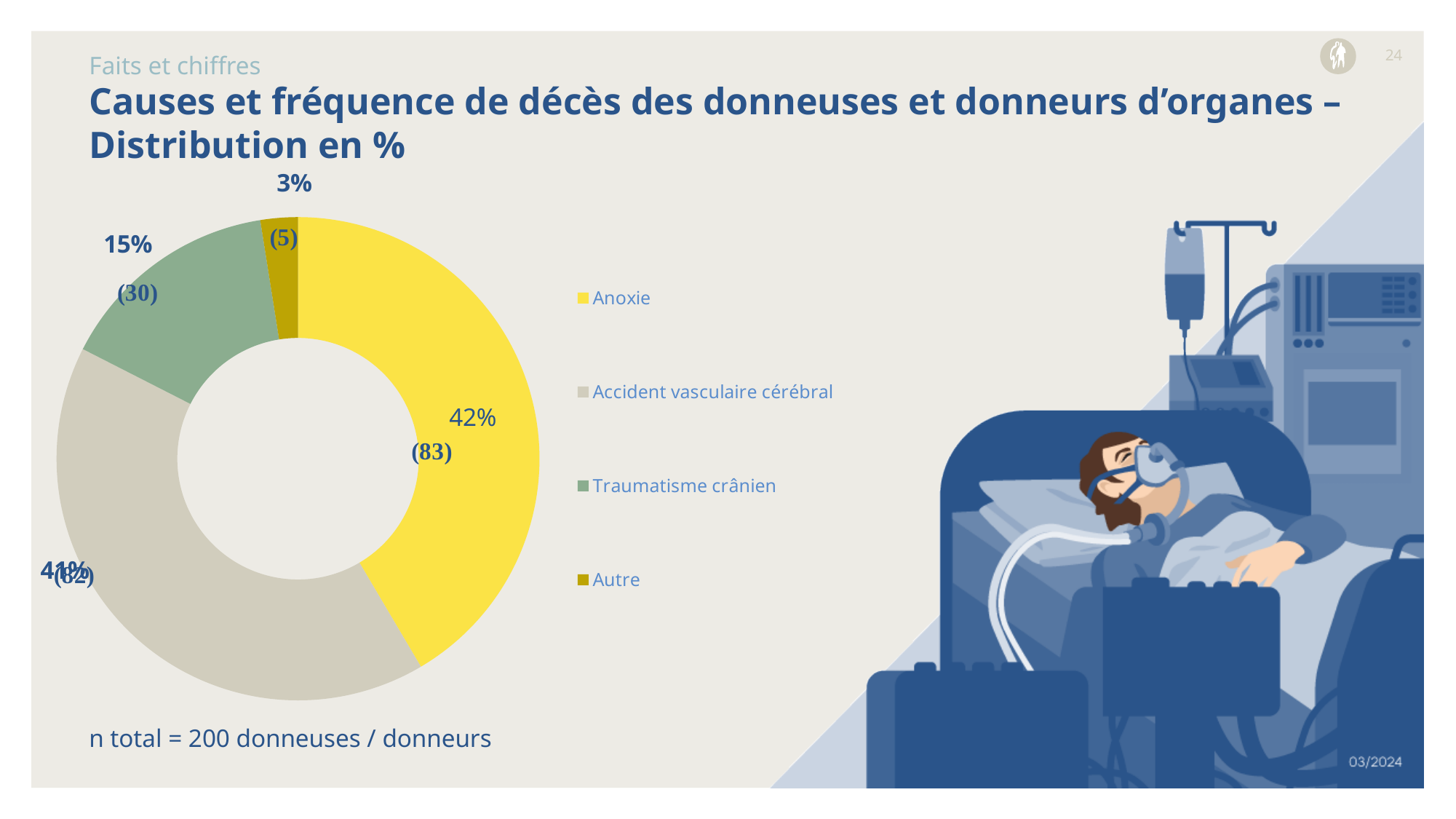
What percentage of the donor deaths is attributed to Traumatisme crânien? 15% Which has the larger share: Traumatisme crânien or Autre? Traumatisme crânien What is the difference in percentage points between Traumatisme crânien and Autre? 12 percentage points How many donors are in the Anoxie category, according to the number in parentheses? 83 How many donors are in the Autre category, according to the number in parentheses? 5 How many categories does the legend of the chart list? 4 How many donors are in the Traumatisme crânien category, according to the number in parentheses? 30 What percentage of the donor deaths is attributed to Autre? 3% What is the total number of donors (n total) stated below the chart? 200 Which cause of death has the smallest share of the chart? Autre What kind of chart is shown on the slide? pie chart (donut) What percentage of the donor deaths is attributed to Anoxie? 42%